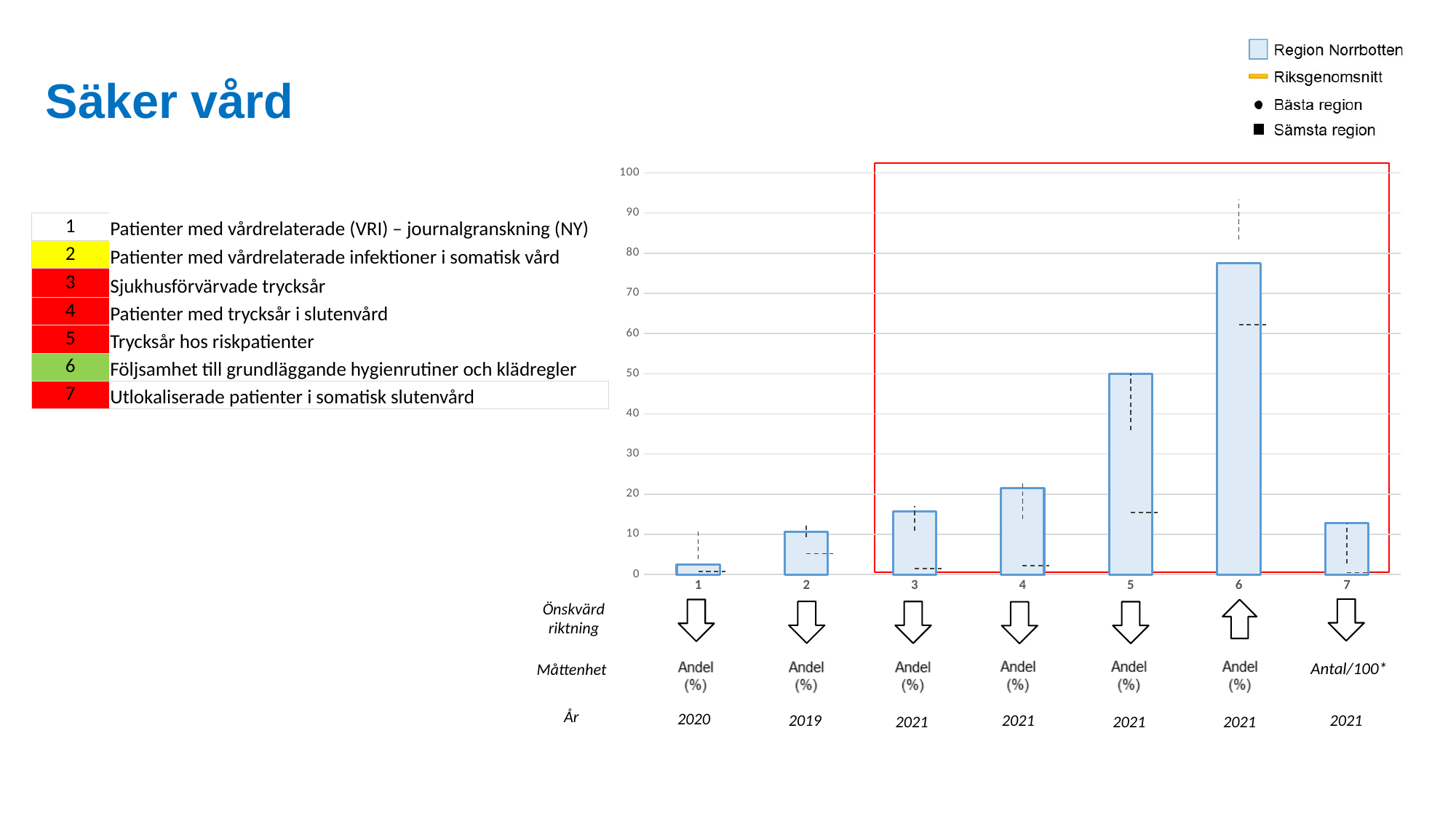
How many categories are plotted along the x axis of the chart? 7 Is the Region Norrbotten bar for category 4 greater or less than 30? less Is the Region Norrbotten bar for category 6 greater or less than 70? greater Which legend entry is represented by the light blue bars? Region Norrbotten Which category has the tallest Region Norrbotten bar? 6 Is the Region Norrbotten bar for category 1 greater or less than 10? less Which category has the shortest Region Norrbotten bar? 1 What kind of chart is shown on the slide? bar chart Which has the larger Region Norrbotten bar, category 5 or category 4? 5 What is the title of the slide containing the chart? Säker vård How many entries does the chart legend list? 4